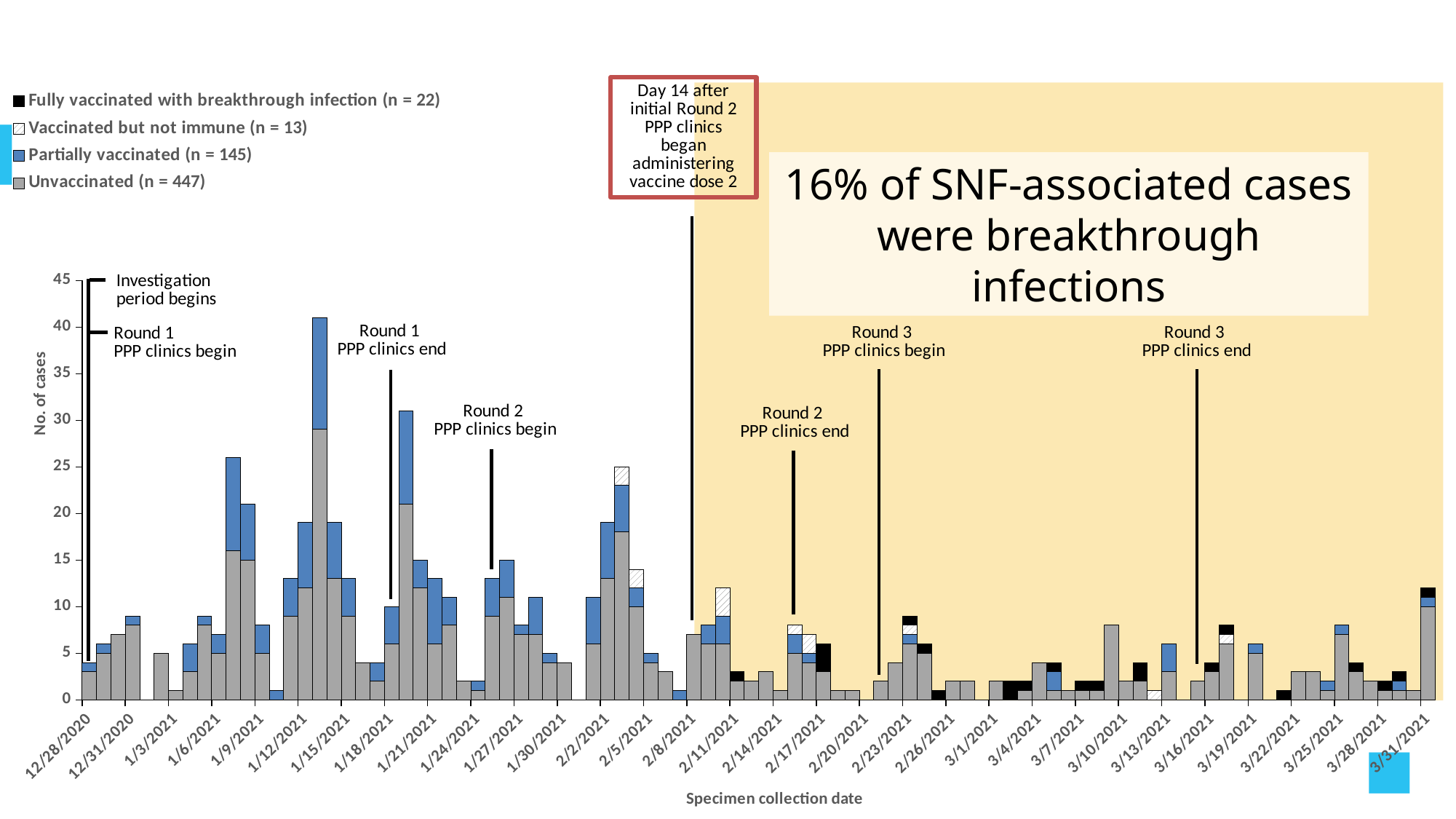
Which date has more total cases, 1/9/2021 or 1/3/2021? 1/9/2021 Are daily case counts generally higher before or after 2/8/2021? before Is the total number of cases on 1/3/2021 greater or less than 5? less How many series does the legend list? 4 According to the legend, how many cases were unvaccinated? 447 Is the total number of cases on 1/30/2021 greater or less than 5? less What kind of chart is shown on the slide? stacked bar chart According to the legend, how many cases were fully vaccinated with breakthrough infection? 22 Which date has more total cases, 1/21/2021 or 3/22/2021? 1/21/2021 Is the total number of cases on 3/31/2021 greater or less than 10? greater